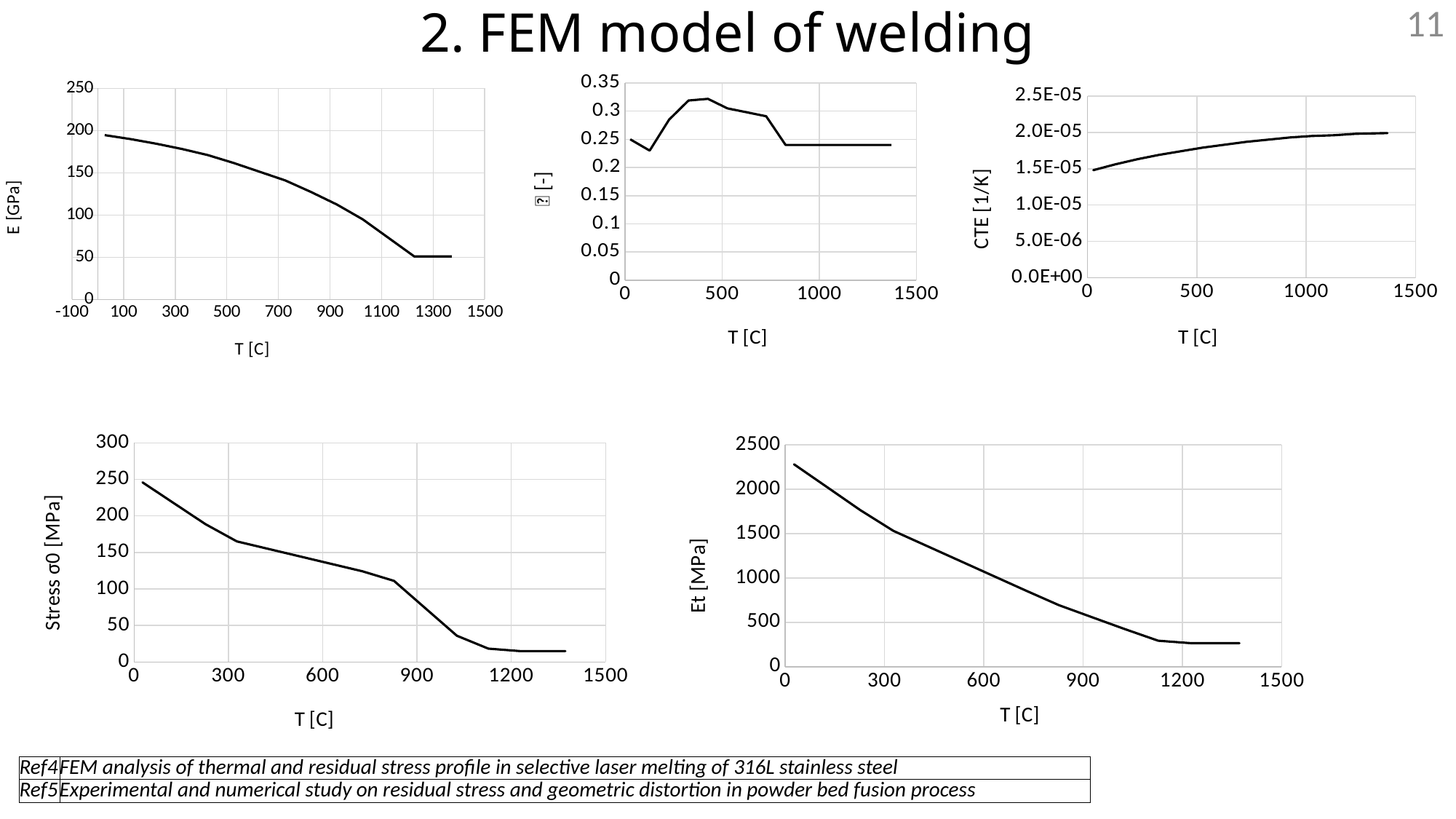
In the top-left chart (E [GPa]), do the values rise or fall as T increases? fall In the bottom-right chart (Et [MPa]), do the values rise or fall as T increases? fall How many charts are shown on the slide? 5 In the bottom-right chart (Et [MPa]), is the value at T = 300 greater or less than 1000? greater What is the y-axis label of the bottom-right chart? Et [MPa] In the top-middle chart (y axis in [-]), is the value at T = 1000 greater or less than 0.3? less In the top-left chart (E [GPa]), is the value at T = 100 greater or less than 150? greater In the top-right chart (CTE [1/K]), do the values rise or fall as T increases? rise What kind of chart is the top-left chart with the y axis labelled E [GPa]? line chart